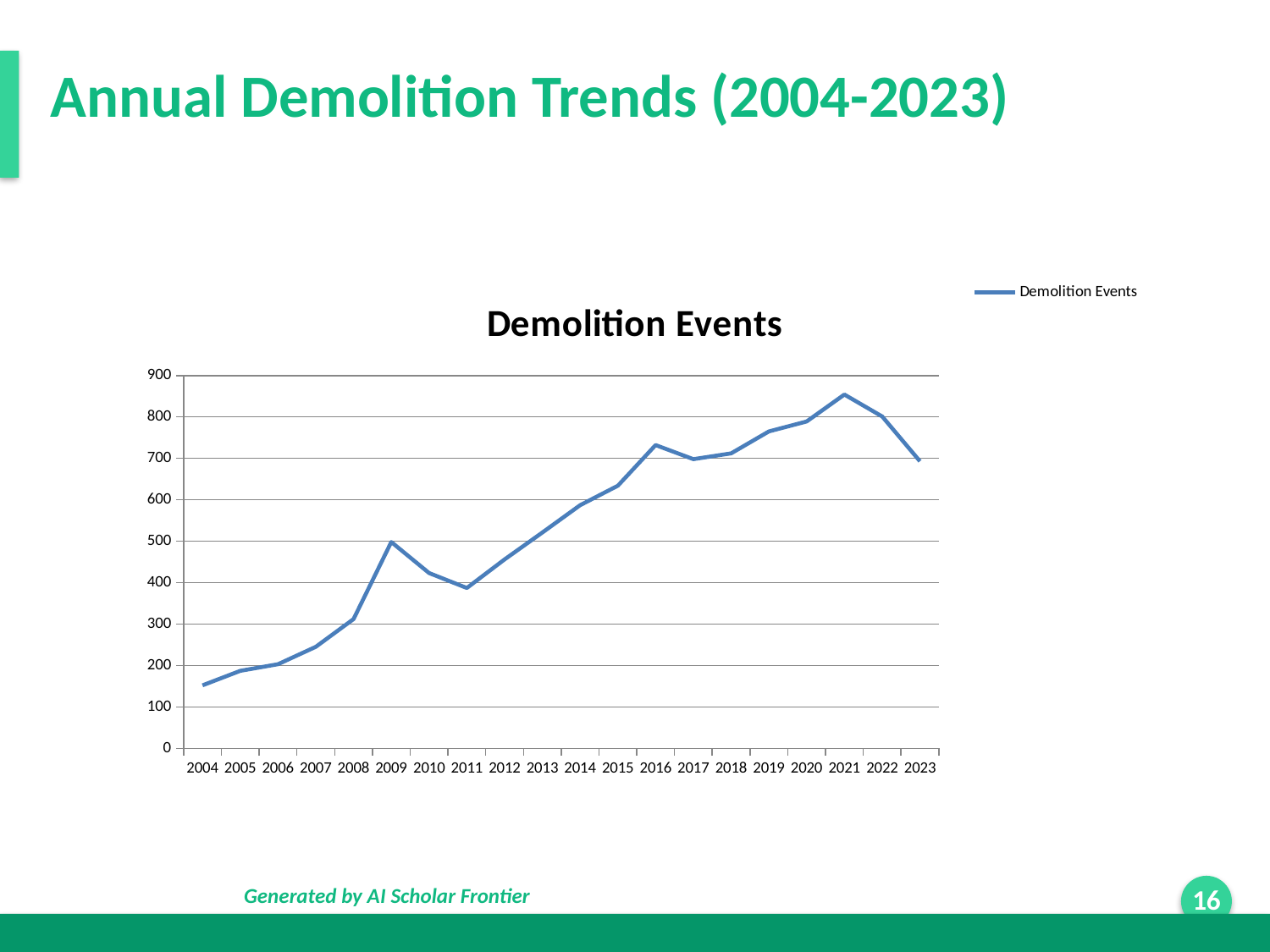
How many years are plotted on the x axis? 20 Which year has the larger value, 2021 or 2023? 2021 What is the title of the chart? Demolition Events Which year has the larger value, 2009 or 2010? 2009 Which year has the highest number of demolition events? 2021 Overall, do the values rise or fall from 2004 to 2023? rise Is the value for 2004 greater or less than 200? less Is the value for 2013 greater or less than 500? greater Is the value for 2021 greater or less than 800? greater Which year has the lowest number of demolition events? 2004 How many series does the legend list? 1 What kind of chart is shown on the slide? line chart